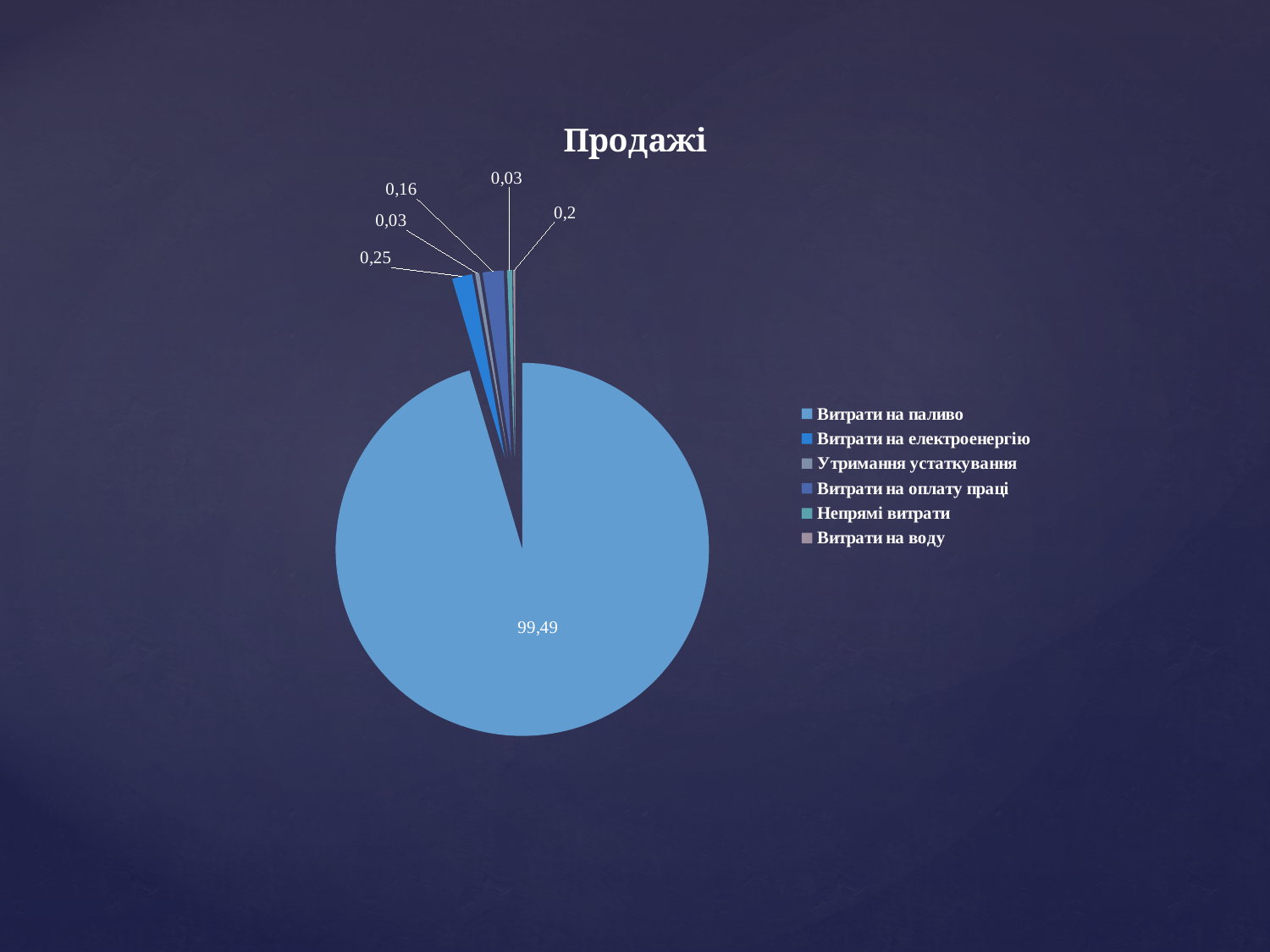
Which category has the largest slice of the pie? Витрати на паливо What is the title of the chart? Продажі What value is shown for Витрати на електроенергію? 0,25 What value is shown for Витрати на паливо? 99,49 What is the difference between the values for Витрати на паливо and Витрати на електроенергію? 99,24 What value is shown for Витрати на оплату праці? 0,16 What is the difference between the values for Витрати на електроенергію and Витрати на воду? 0,05 Which is larger, the value for Витрати на електроенергію or the value for Витрати на оплату праці? Витрати на електроенергію How many entries does the legend list? 6 What value is shown for Витрати на воду? 0,2 What kind of chart is shown on the slide? pie chart How many slices does the pie chart have? 6